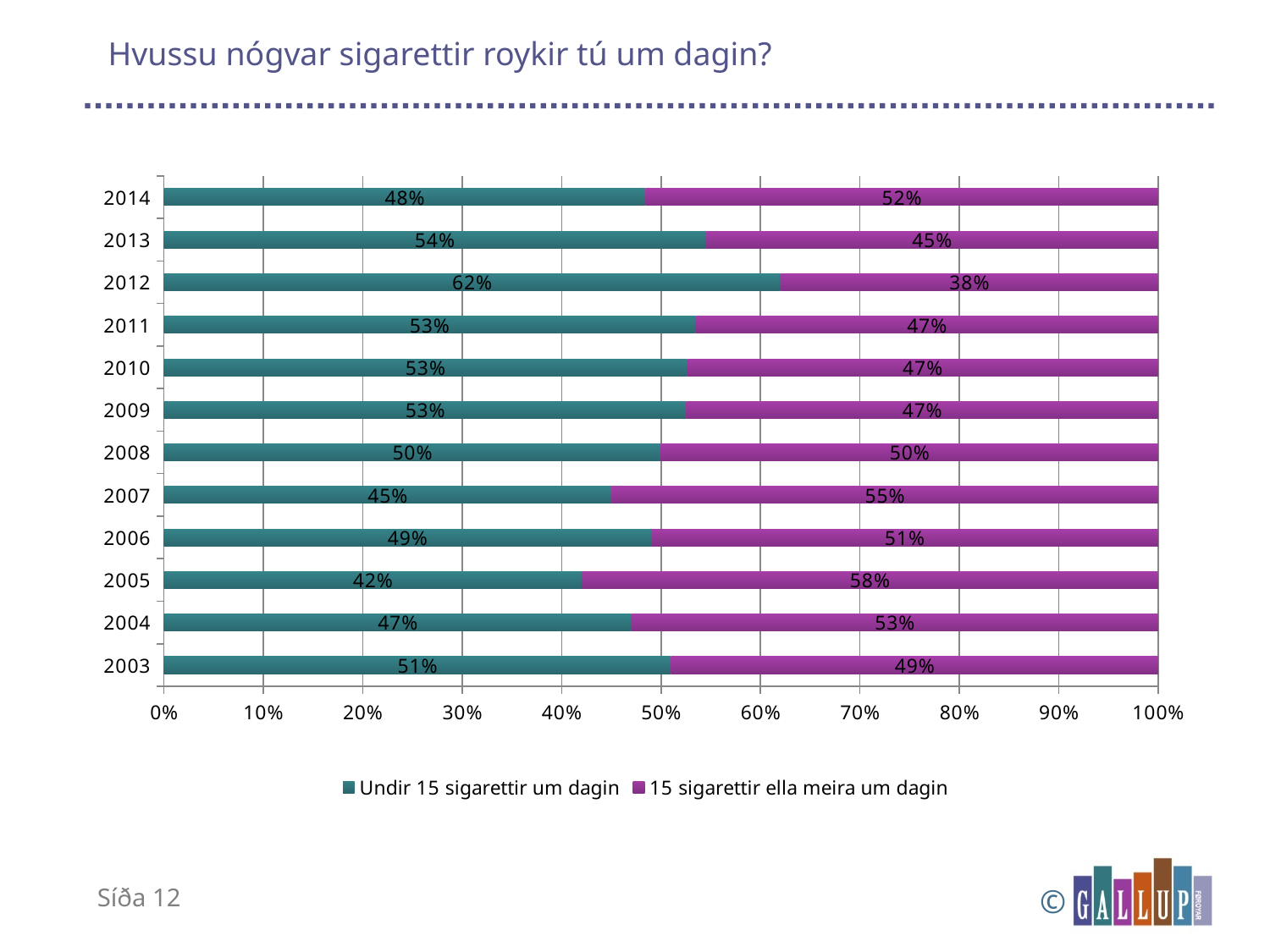
What is the title of the slide? Hvussu nógvar sigarettir roykir tú um dagin? What is the value for '15 sigarettir ella meira um dagin' in 2005? 58% How many years are shown on the chart? 12 What is the total of the two segments for the 2013 bar? 99% How many series does the legend list? 2 What is the difference between the 'Undir 15 sigarettir um dagin' values for 2012 and 2014? 14 percentage points What is the value for 'Undir 15 sigarettir um dagin' in 2003? 51% In which year is the share of 'Undir 15 sigarettir um dagin' the lowest? 2005 In which year is the share of 'Undir 15 sigarettir um dagin' the highest? 2012 Which is larger in 2007: 'Undir 15 sigarettir um dagin' or '15 sigarettir ella meira um dagin'? 15 sigarettir ella meira um dagin What percentage of respondents in 2014 smoked under 15 cigarettes a day (Undir 15 sigarettir um dagin)? 48% What kind of chart is shown on the slide? Stacked bar chart